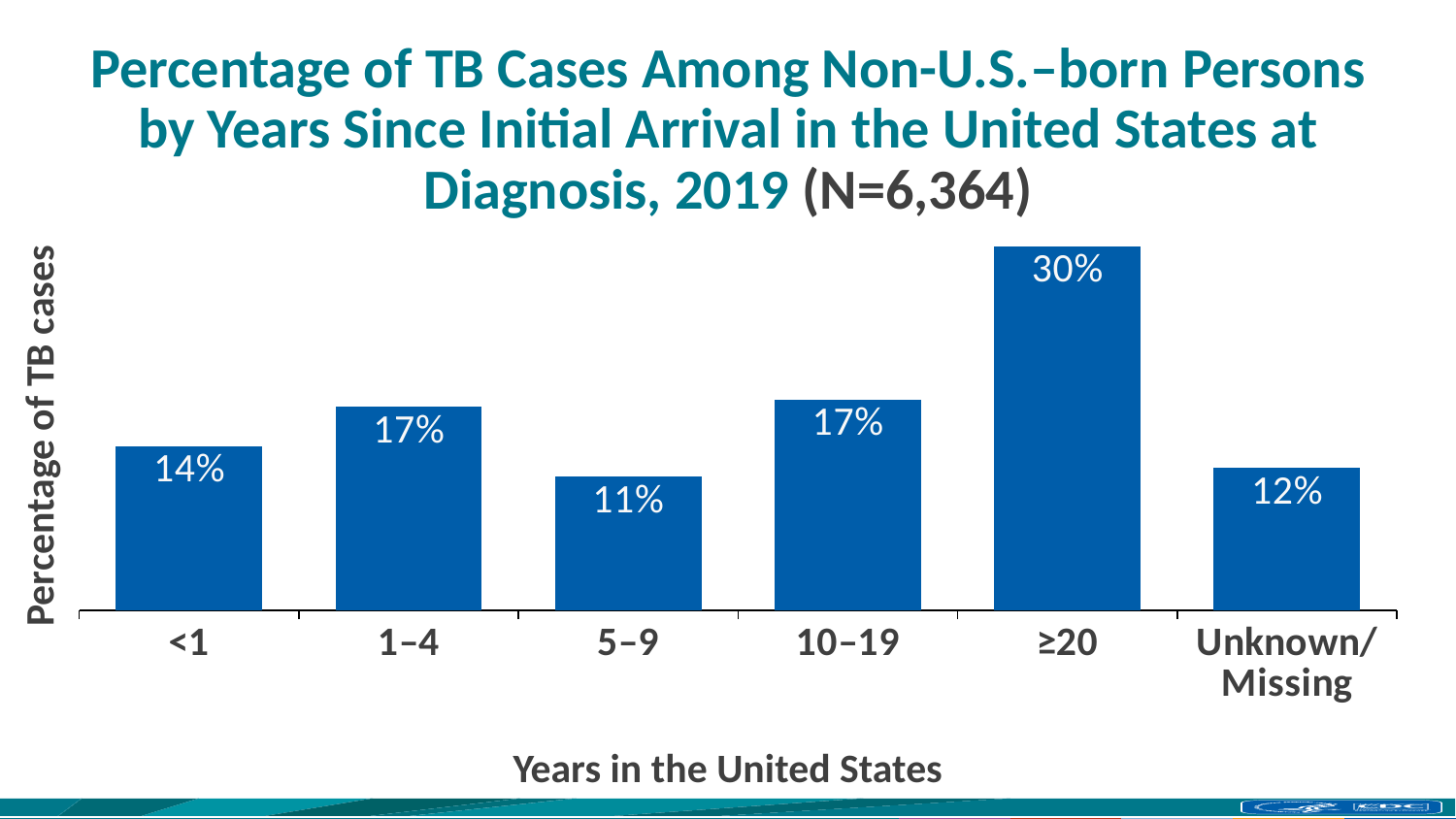
What is the label of the x axis? Years in the United States Which category has the lowest percentage of TB cases? 5–9 What percentage of TB cases is shown for the ≥20 years category? 30% Which is larger, the value for <1 year or the value for Unknown/Missing? <1 Which years-in-the-United-States category has the highest percentage of TB cases? ≥20 How many categories are shown on the x axis? 6 What is the value for the 5–9 years category? 11% What kind of chart is shown on the slide? Bar chart What is the total number of cases (N) given in the chart title? 6,364 What percentage of TB cases among non-U.S.-born persons had been in the United States for less than 1 year at diagnosis? 14% What is the value for the Unknown/Missing category? 12% What is the difference in percentage points between the ≥20 category and the 1–4 category? 13